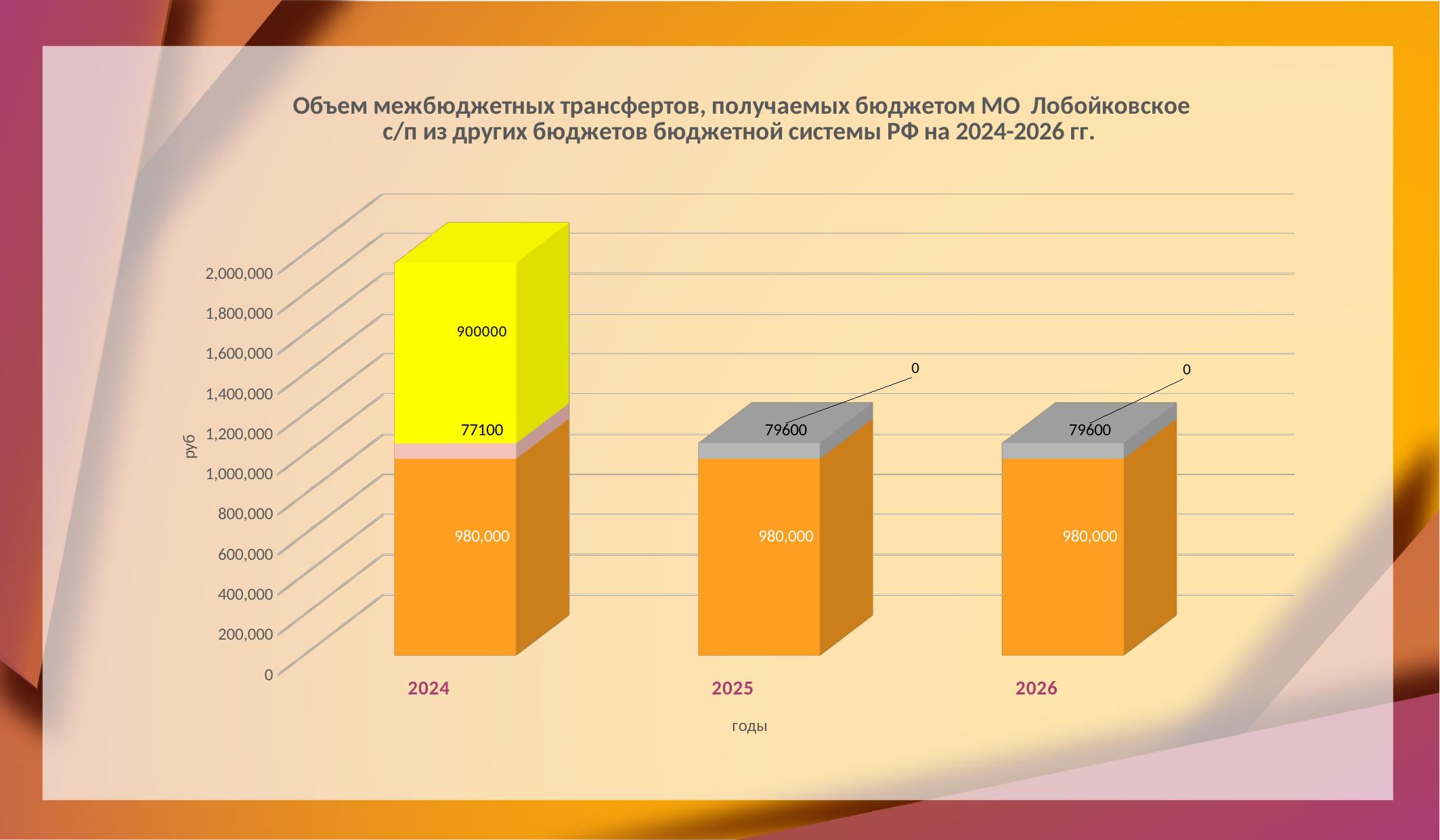
What kind of chart is shown on the slide? bar chart What is the difference between the grey segment of 2025 (79600) and the pink segment of 2024 (77100)? 2500 What is the value of the grey segment of the 2025 bar? 79600 How many years are shown on the x axis of the chart? 3 What is the value of the orange segment of the 2024 bar? 980,000 What is the total of the stacked bar for 2025? 1,059,600 What is the value of the orange segment of the 2026 bar? 980,000 What is the total of the stacked bar for 2024? 1,957,100 What is the value of the pink segment of the 2024 bar? 77100 Which year has the tallest stacked bar? 2024 What is the value of the yellow segment of the 2024 bar? 900000 What is the title of the x axis of the chart? годы